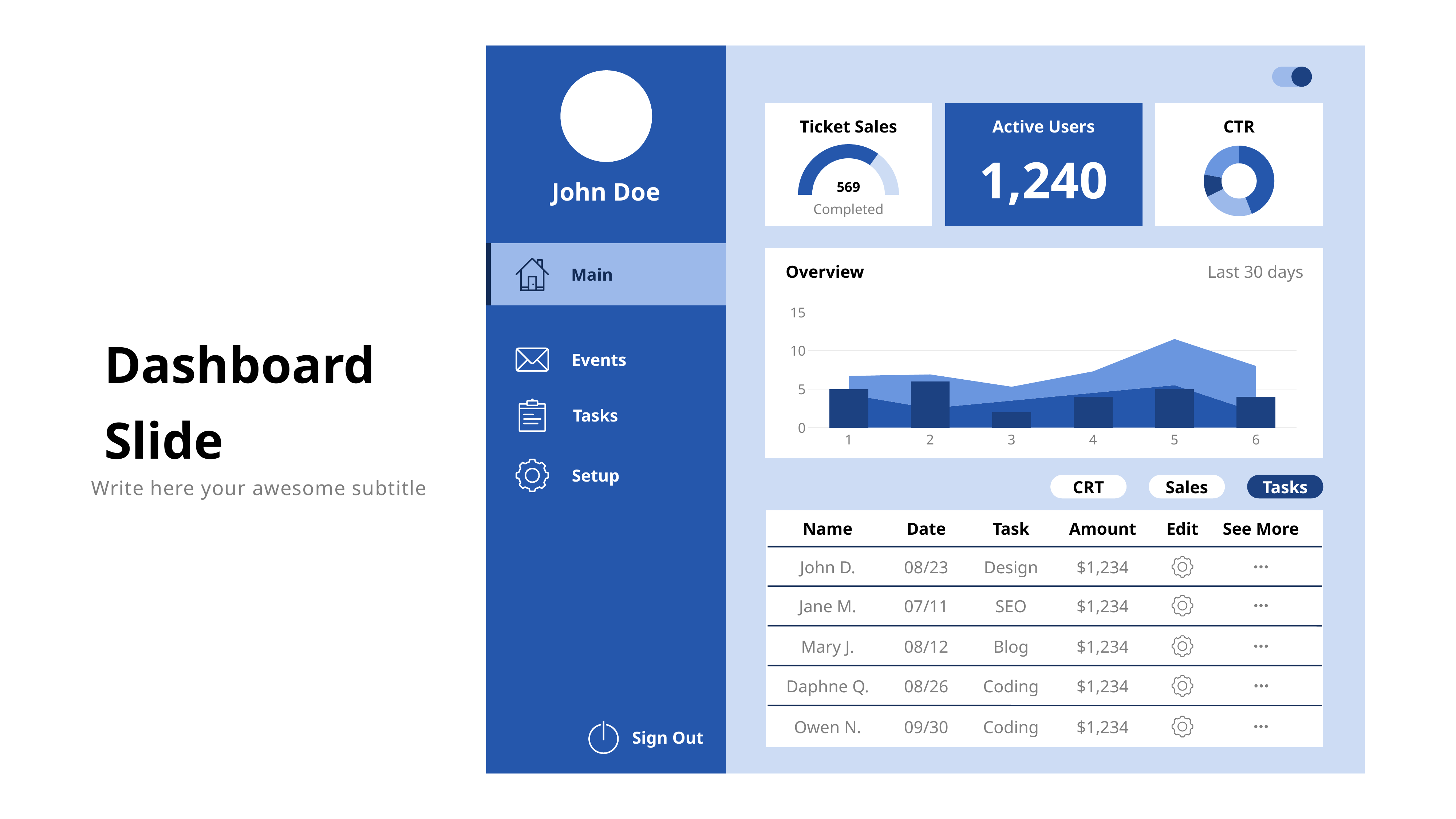
What time period does the Overview chart cover, according to the label at its top right? Last 30 days In the Overview chart, is the bar for category 2 taller or shorter than the bar for category 3? taller In the Overview chart, do the bars rise or fall from category 2 to category 3? fall What value is shown in the centre of the Ticket Sales gauge? 569 In the Overview chart, is the peak of the light blue area at category 5 greater or less than 10? greater In the Overview chart, which category has the lowest bar? 3 In the Overview chart, what is the highest value shown on the y axis? 15 What kind of chart is shown in the CTR card? Donut chart In the Overview chart, how many categories are shown on the x axis? 6 In the Overview chart, is the bar for category 2 greater or less than 5? greater In the Overview chart, which category has the tallest bar? 2 In the Overview chart, is the bar for category 3 greater or less than 5? less